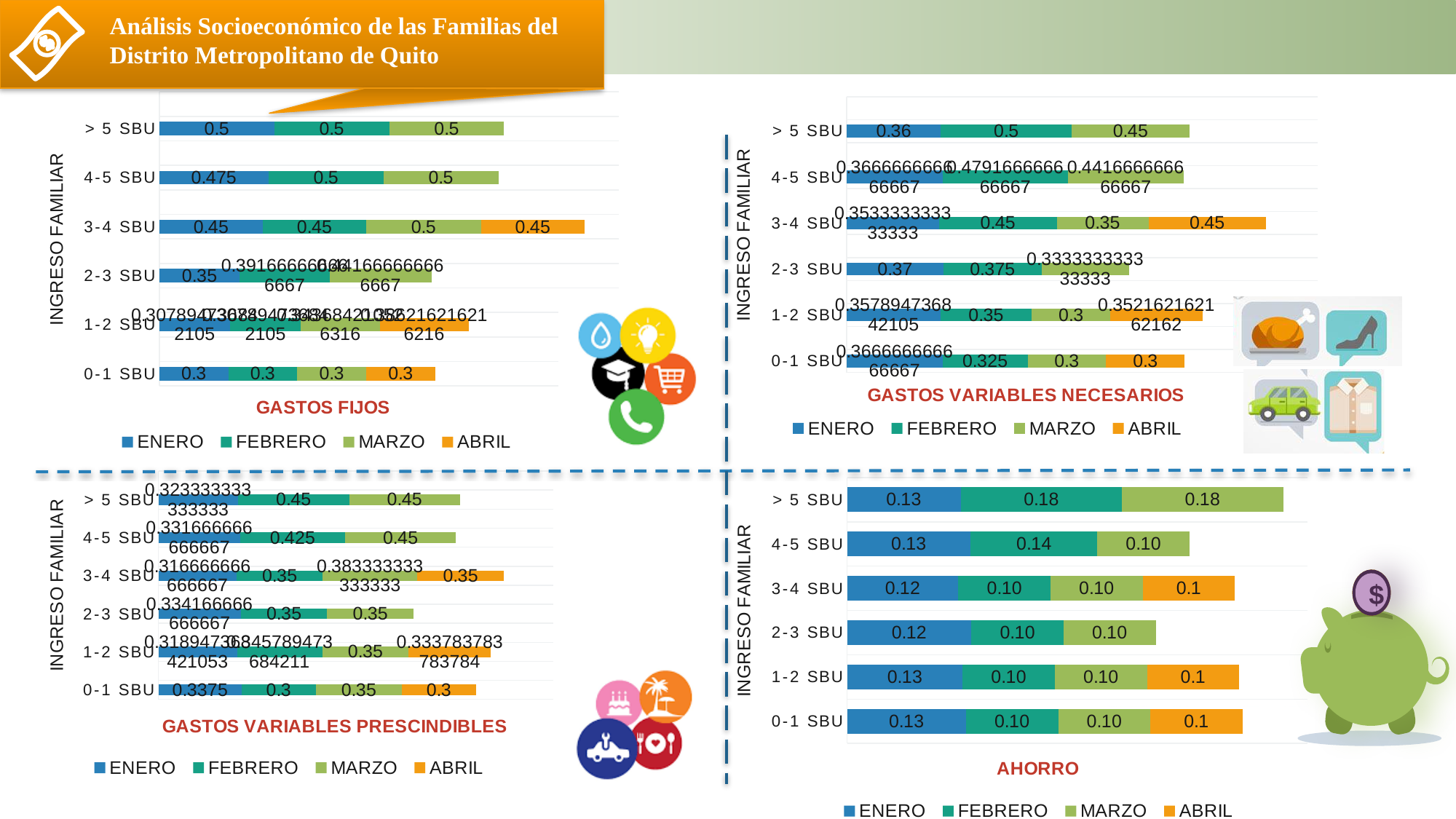
In the GASTOS FIJOS chart, what is the ENERO value for 4-5 SBU? 0.475 In the AHORRO chart, which is larger for 4-5 SBU: the FEBRERO value or the MARZO value? FEBRERO In the GASTOS FIJOS chart, what is the ABRIL value for 3-4 SBU? 0.45 In the GASTOS VARIABLES NECESARIOS chart, what is the FEBRERO value for 0-1 SBU? 0.325 In the GASTOS VARIABLES NECESARIOS chart, what is the difference between the FEBRERO and MARZO values for 3-4 SBU? 0.1 In the AHORRO chart, what is the total of the stacked bar for 0-1 SBU? 0.43 How many series does the legend of the AHORRO chart list? 4 In the GASTOS VARIABLES NECESARIOS chart, what is the ENERO value for > 5 SBU? 0.36 In the GASTOS VARIABLES PRESCINDIBLES chart, what is the ENERO value for 0-1 SBU? 0.3375 In the GASTOS FIJOS chart, what is the total of the stacked bar for 0-1 SBU? 1.2 In the AHORRO chart, what is the FEBRERO value for > 5 SBU? 0.18 In the GASTOS VARIABLES PRESCINDIBLES chart, what is the FEBRERO value for 4-5 SBU? 0.425